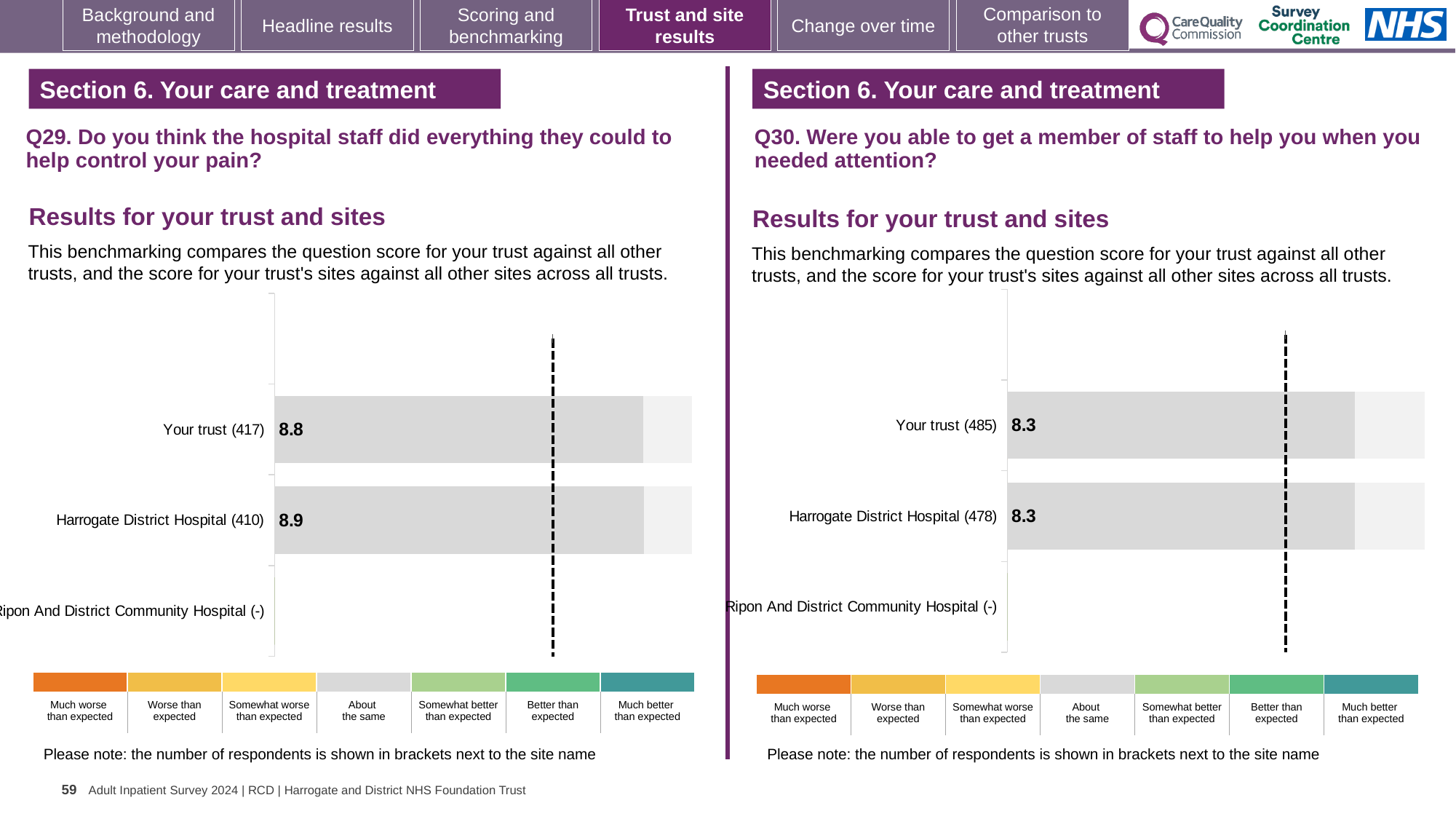
In the Q30 chart on the right, is the score for Your trust higher than, lower than, or equal to the score for Harrogate District Hospital? Equal In the Q29 chart on the left, what is the score for Your trust? 8.8 In the Q29 chart on the left, what is the score for Harrogate District Hospital? 8.9 In the Q29 chart on the left, which site has no score shown? Ripon And District Community Hospital In the Q29 chart on the left, which has the higher score: Your trust or Harrogate District Hospital? Harrogate District Hospital In the Q30 chart on the right, what is the score for Harrogate District Hospital? 8.3 In the Q30 chart on the right, how many respondents are shown in brackets for Harrogate District Hospital? 478 In the Q30 chart on the right, what is the score for Your trust? 8.3 How many sites or categories are listed on the y axis of the Q29 chart on the left? 3 In the Q29 chart on the left, what is the difference between the Harrogate District Hospital score and the Your trust score? 0.1 What kind of chart is used for the Q30 results on the right? Bar chart In the Q29 chart on the left, how many respondents are shown in brackets for Your trust? 417